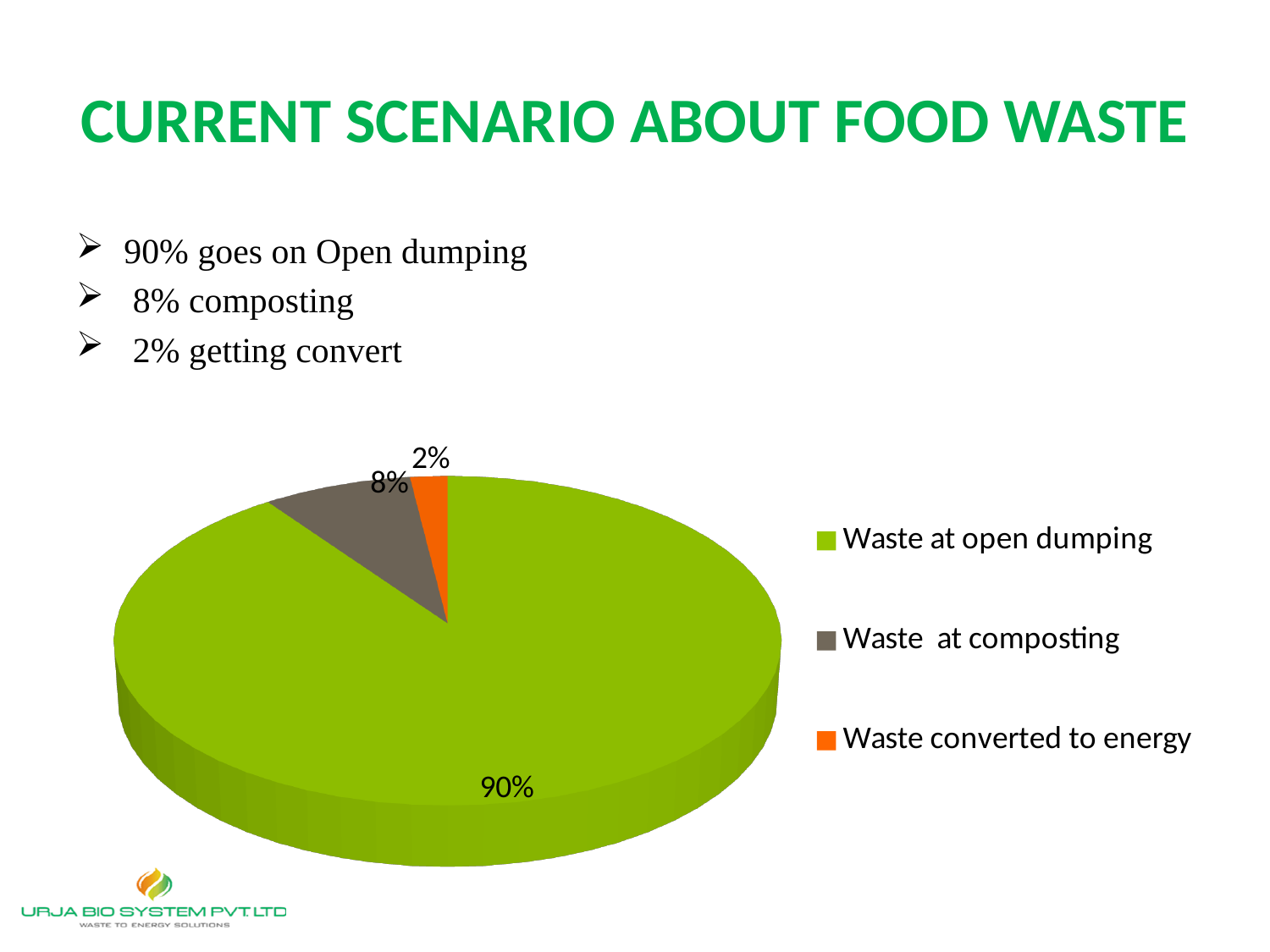
How many entries does the legend list? 3 What is the difference between the shares for Waste at composting and Waste converted to energy? 6% What kind of chart is shown on the slide? pie chart What share of the pie is labelled for Waste at open dumping? 90% How many slices does the pie chart have? 3 Which category has the largest slice of the pie? Waste at open dumping Which category has the smallest slice of the pie? Waste converted to energy What is the difference between the shares for Waste at open dumping and Waste at composting? 82% Which is larger, the slice for Waste at composting or the slice for Waste converted to energy? Waste at composting What colour is the slice for Waste converted to energy? orange What share of the pie is labelled for Waste converted to energy? 2% What share of the pie is labelled for Waste at composting? 8%